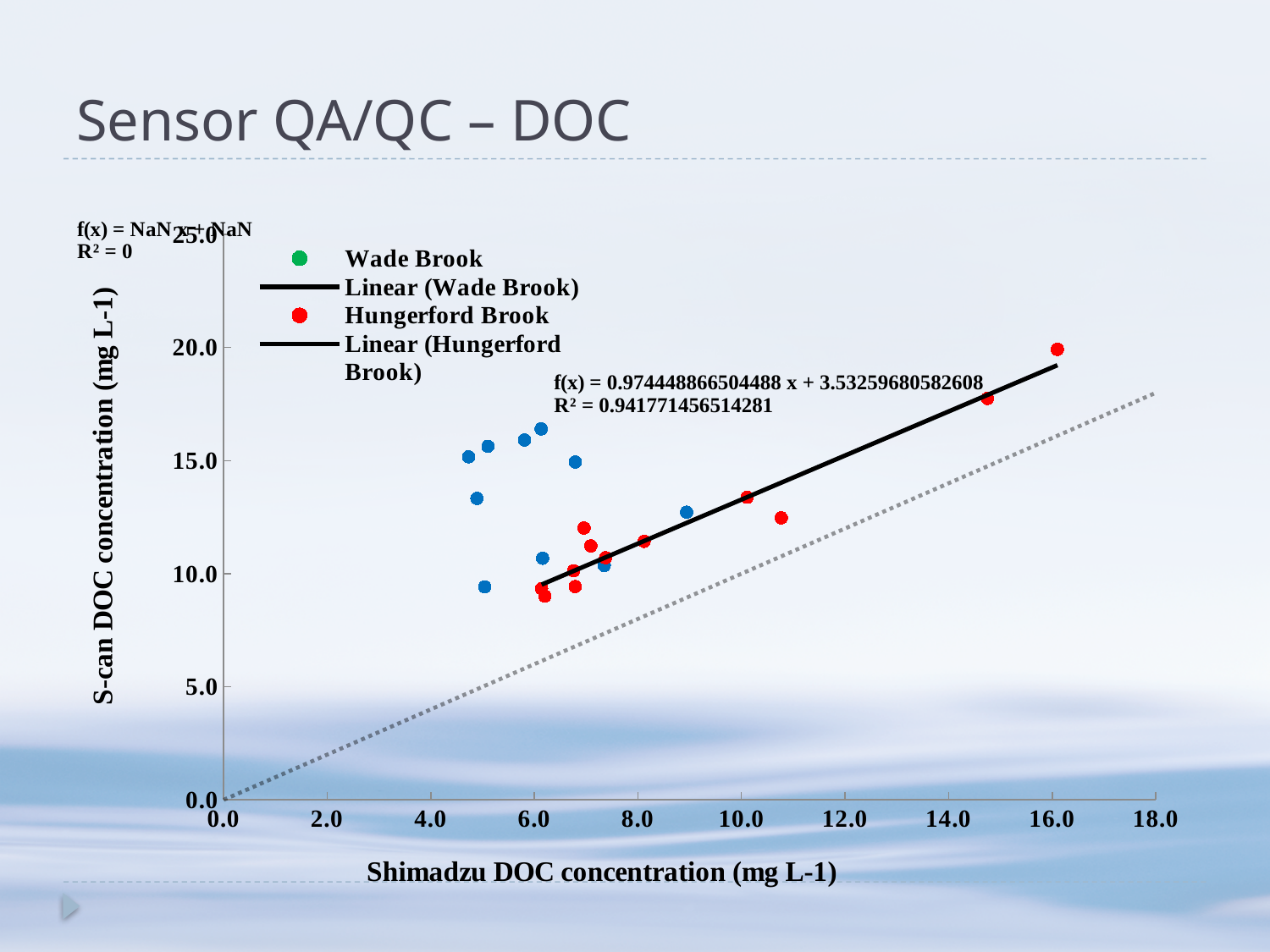
What is the intercept printed in the Hungerford Brook trendline equation? 3.53259680582608 Which series contains the point with the highest S-can DOC concentration, Wade Brook or Hungerford Brook? Hungerford Brook Is the S-can DOC concentration of the highest Hungerford Brook point greater or less than 15.0? greater What is the slope printed in the Hungerford Brook trendline equation? 0.974448866504488 What kind of chart is shown on the slide? Scatter chart What R² value is printed for the Wade Brook linear fit? 0 How many entries does the chart legend list? 4 Do the Hungerford Brook S-can values rise or fall as the Shimadzu DOC concentration increases? rise What is the title of the x axis? Shimadzu DOC concentration (mg L-1) What is the title of the y axis? S-can DOC concentration (mg L-1) What R² value is printed for the Hungerford Brook linear fit? 0.941771456514281